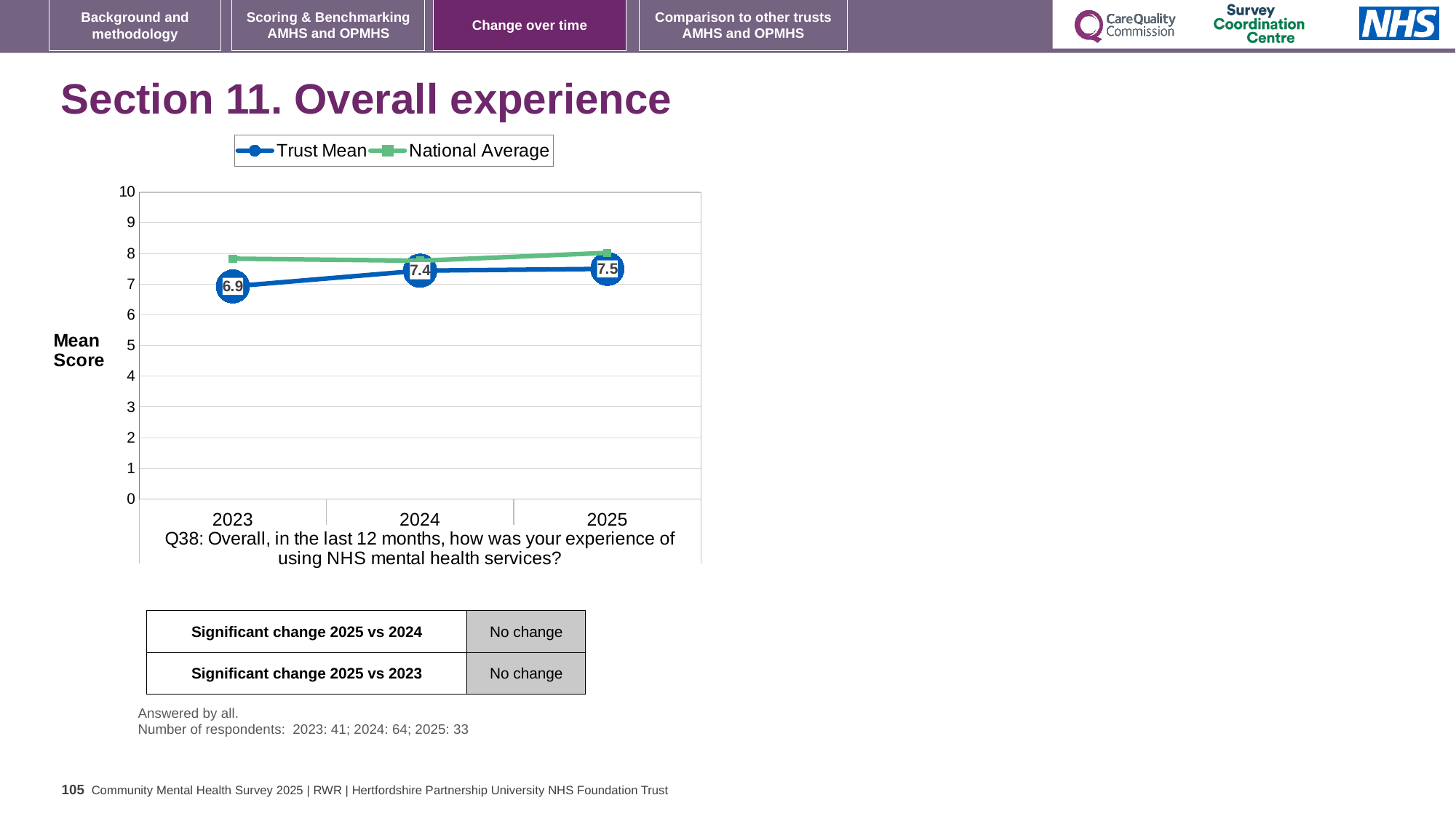
What is the difference between the Trust Mean in 2025 and in 2023? 0.6 Does the Trust Mean rise or fall from 2023 to 2025? rise How many years are plotted on the x axis? 3 In which year is the Trust Mean lowest? 2023 How many series does the legend list? 2 Which is larger, the Trust Mean for 2024 or for 2023? 2024 What is the Trust Mean value for 2024? 7.4 What is the Trust Mean value for 2023? 6.9 Is the National Average value for 2025 greater or less than 7? greater Is the National Average value for 2023 greater or less than 9? less What kind of chart is shown? line chart What is the Trust Mean value for 2025? 7.5